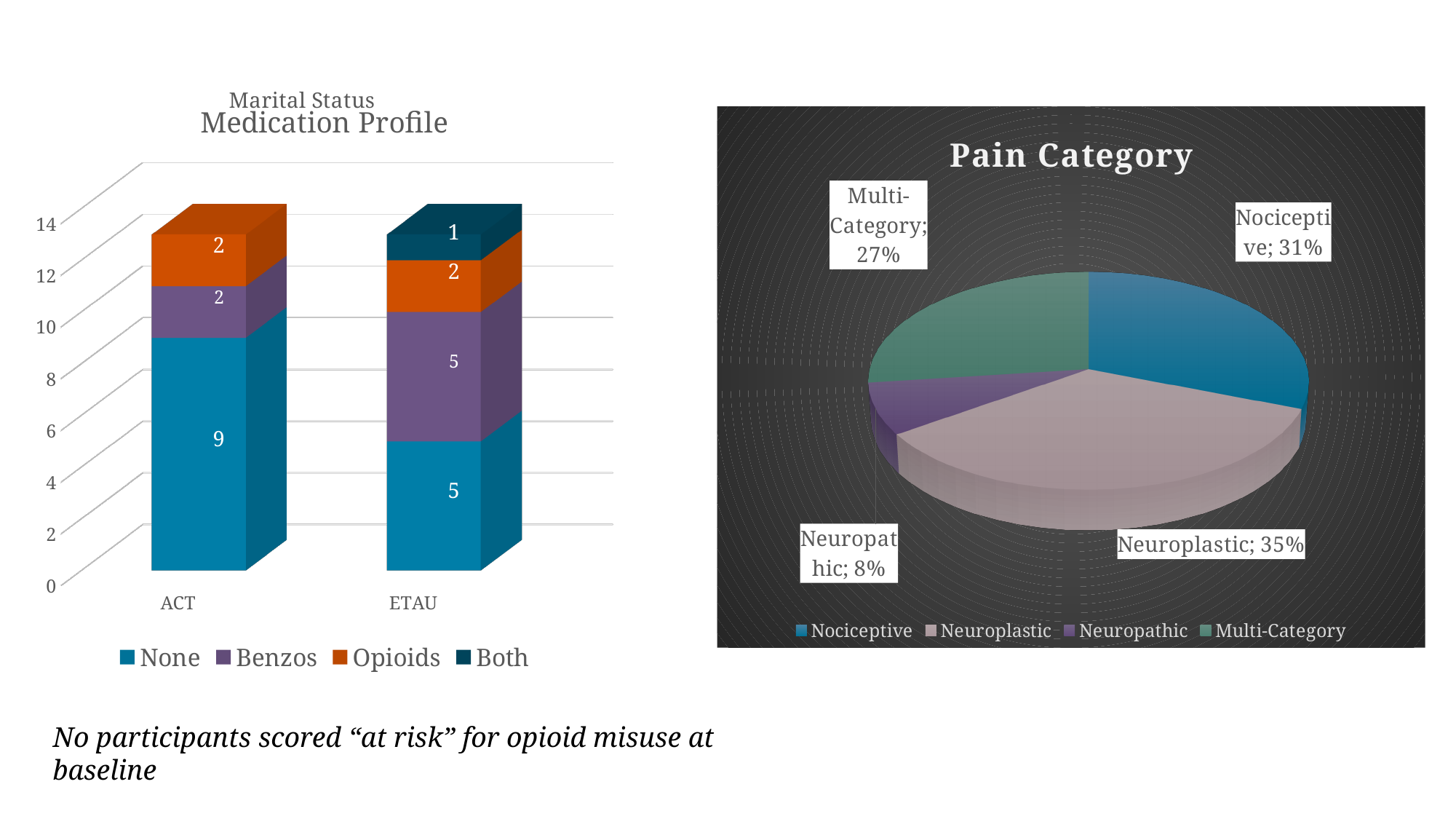
In the Medication Profile chart, how many series does the legend list? 4 In the Medication Profile chart, what is the value of the Both segment for ETAU? 1 In the Pain Category chart, what is the difference between the Nociceptive and Multi-Category shares? 4% In the Medication Profile chart, what is the total of the stacked bar for ETAU? 13 In the Pain Category chart, what share does Neuroplastic have? 35% In the Medication Profile chart, what is the value of the None segment for ACT? 9 In the Medication Profile chart, what is the value of the Benzos segment for ETAU? 5 What kind of chart is the Pain Category chart? Pie chart In the Medication Profile chart, what is the difference between the None values for ACT and ETAU? 4 In the Pain Category chart, which category has the smallest share? Neuropathic In the Medication Profile chart, which group has the larger None value, ACT or ETAU? ACT What kind of chart is the Medication Profile chart? Stacked bar chart